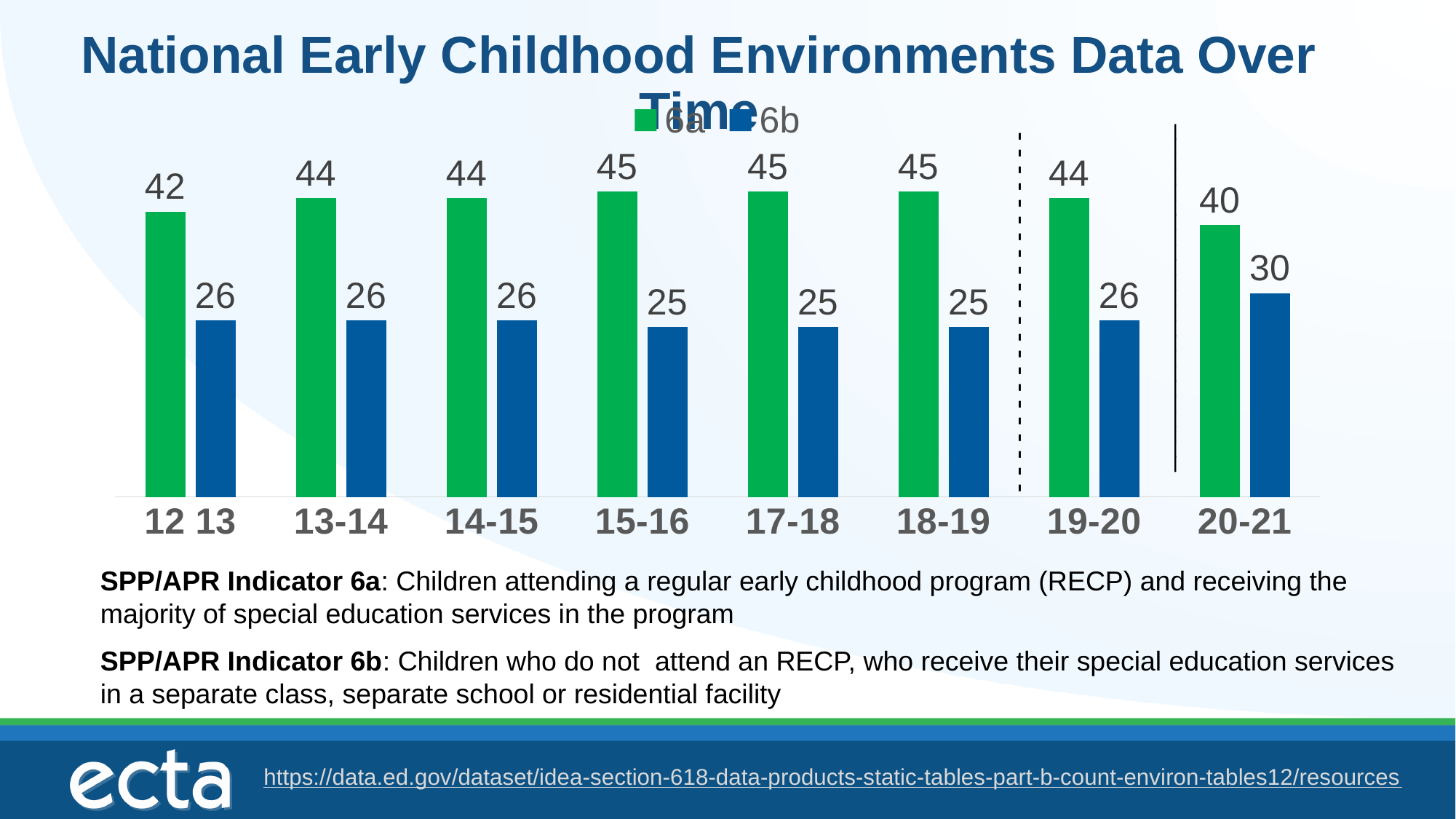
What is the difference between the 6a value for 18-19 and the 6a value for 20-21? 5 What kind of chart is shown on the slide? Bar chart How many series does the legend list? 2 What is the value of 6a for 13-14? 44 What is the difference between 6a and 6b in 20-21? 10 What is the value of 6b for 20-21? 30 Which is larger in 19-20, the value for 6a or the value for 6b? 6a Which year has the highest value for 6b? 20-21 What is the value of 6a for 20-21? 40 How many year categories are shown on the x axis? 8 What is the value of 6b for 15-16? 25 Which year has the lowest value for 6a? 20-21